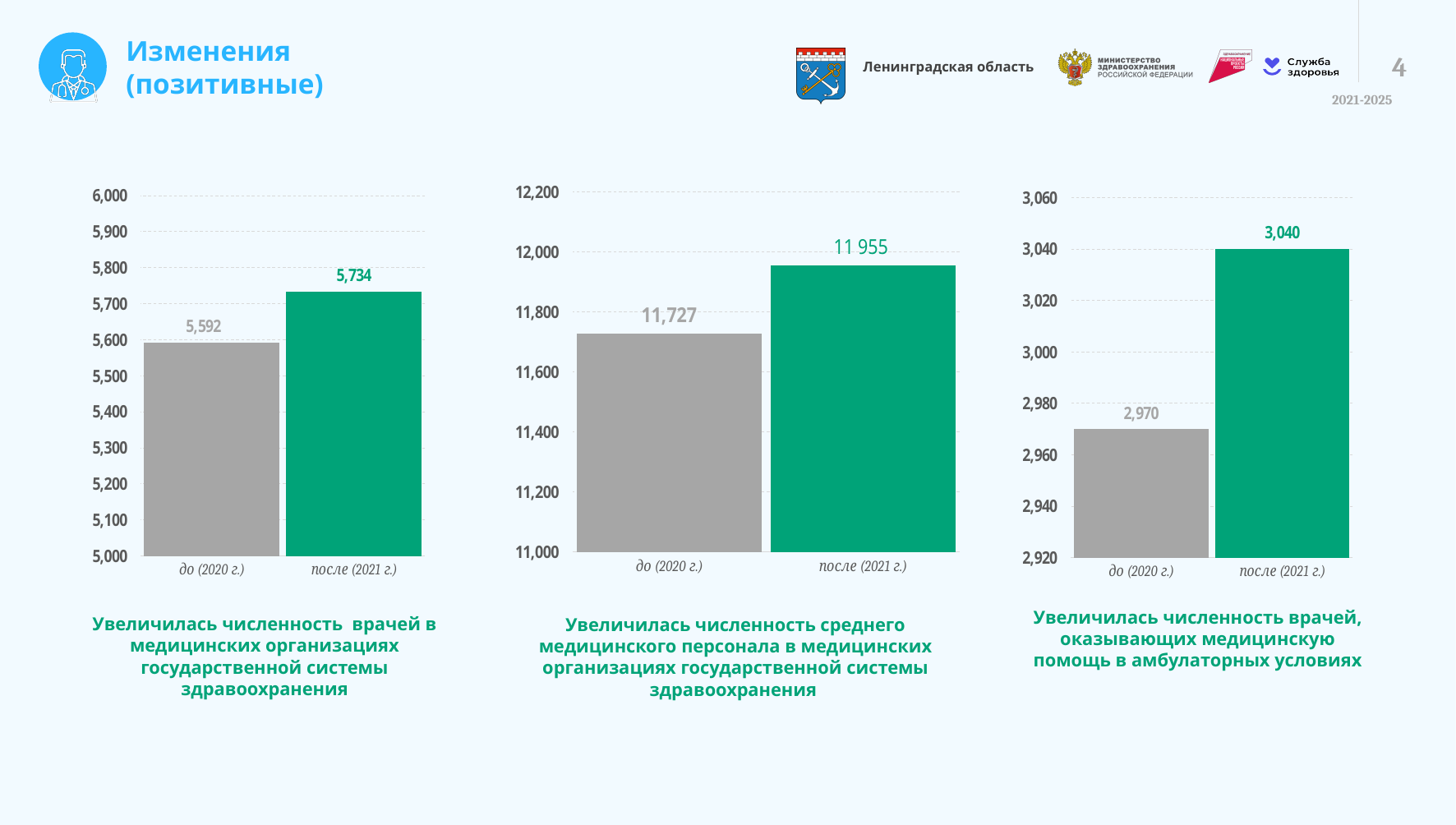
In the right chart, which category has the higher value? после (2021 г.) In the right chart, what is the difference between the two bars? 70 In the middle chart, by how much does the 'после (2021 г.)' value exceed the 'до (2020 г.)' value? 228 How many bars does the left chart have? 2 In the right chart, what is the value for 'после (2021 г.)'? 3,040 In the left chart, what is the difference between the 'после (2021 г.)' and 'до (2020 г.)' values? 142 In the left chart, what is the value for 'после (2021 г.)'? 5,734 In the middle chart, what is the value for 'до (2020 г.)'? 11,727 What kind of chart is the middle chart? bar chart In the left chart, what is the value for 'до (2020 г.)'? 5,592 In the middle chart, what is the value for 'после (2021 г.)'? 11 955 In the right chart, what is the value for 'до (2020 г.)'? 2,970